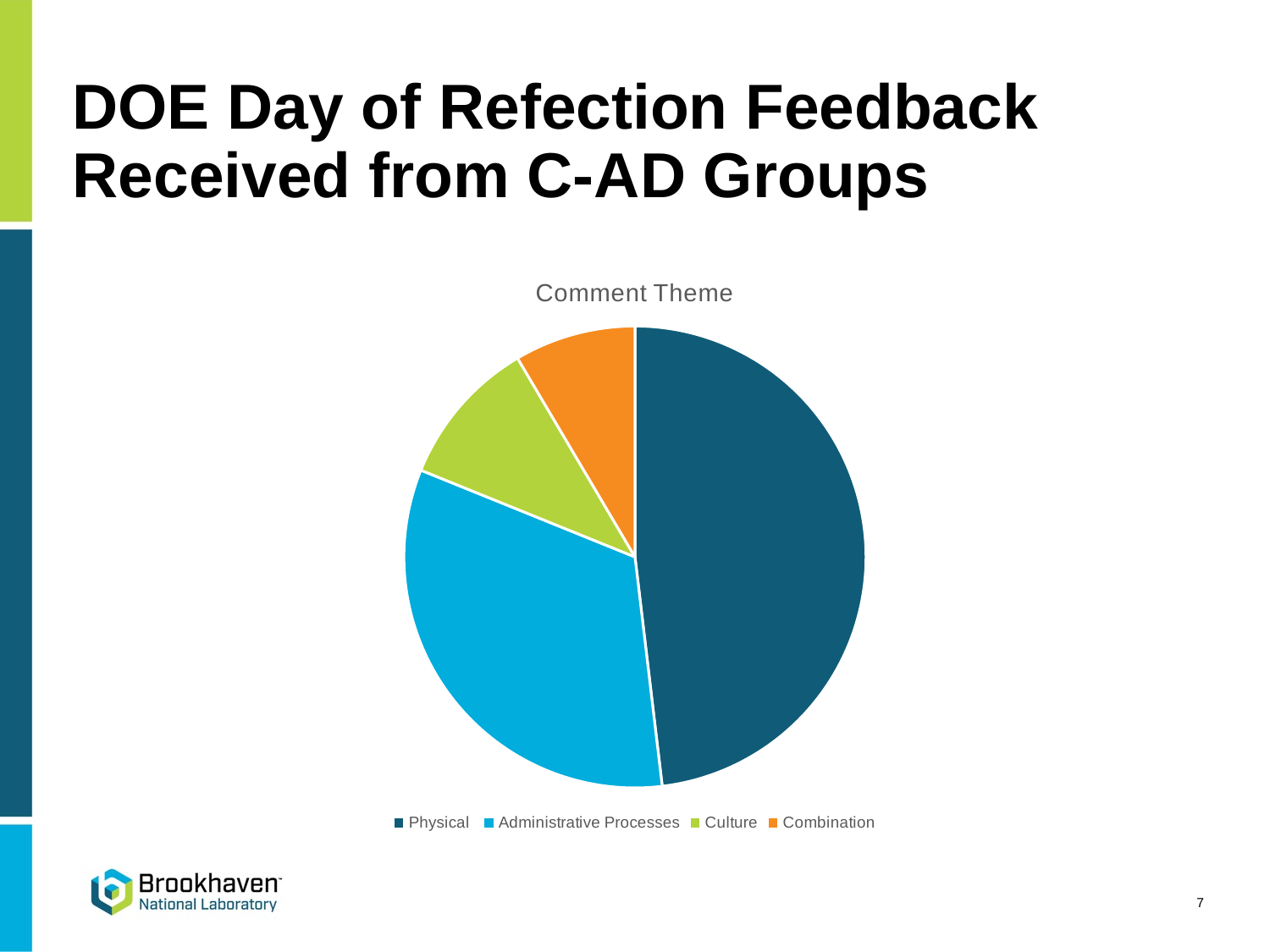
What is the title of the chart? Comment Theme Which comment theme has the smallest slice of the pie? Combination Which slice is larger, Culture or Combination? Culture How many entries does the legend list? 4 Which comment theme has the largest slice of the pie? Physical Which slice is larger, Administrative Processes or Culture? Administrative Processes Which legend entry is shown in orange? Combination How many slices does the pie chart have? 4 Which slice is larger, Physical or Administrative Processes? Physical What kind of chart is shown on the slide? pie chart